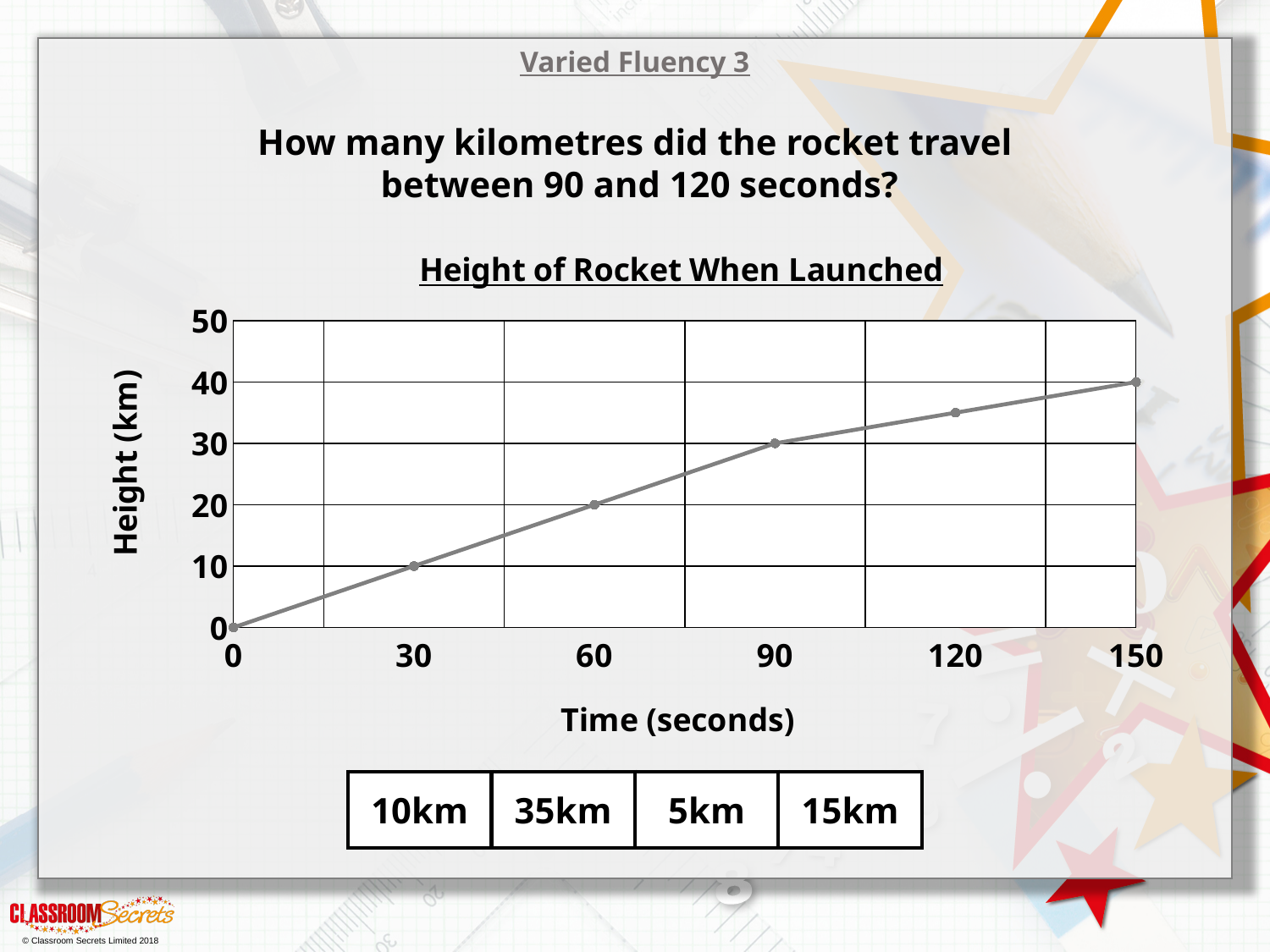
What is the height of the rocket at 60 seconds? 20 Is the height of the rocket at 120 seconds greater or less than 30? greater Does the height of the rocket rise or fall as time increases? rise What kind of chart is shown on the slide? line chart Is the height of the rocket at 120 seconds greater or less than 40? less What is the height of the rocket at 30 seconds? 10 What is the height of the rocket at 150 seconds? 40 What is the title of the chart? Height of Rocket When Launched How many data points are plotted on the line? 6 What is the label of the x axis? Time (seconds) At which time is the height of the rocket highest? 150 What is the height of the rocket at 90 seconds? 30